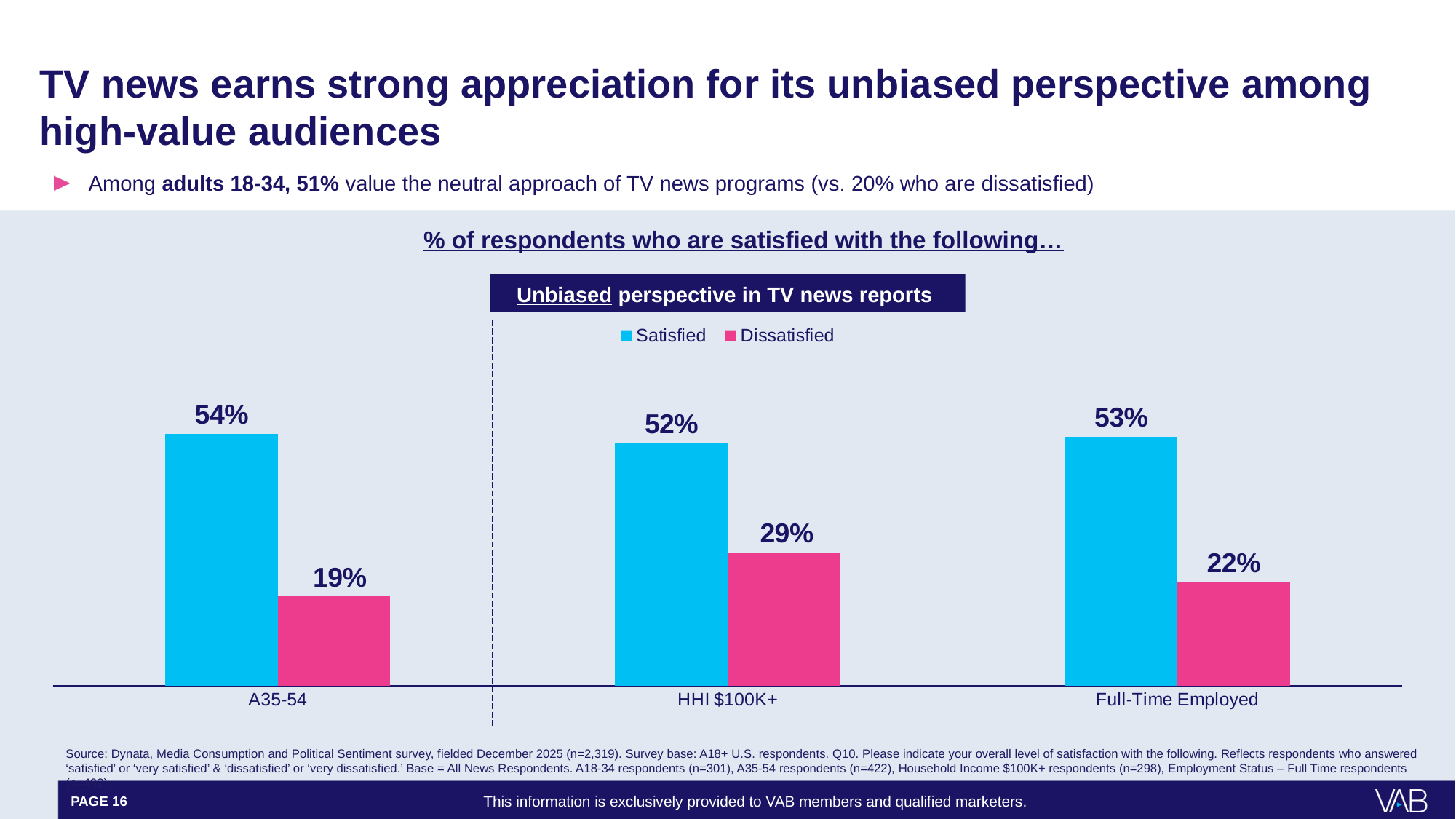
Is the Dissatisfied value larger for HHI $100K+ or for Full-Time Employed? HHI $100K+ What is the difference between the Satisfied and Dissatisfied values for Full-Time Employed respondents? 31 percentage points What percentage of A35-54 respondents are satisfied with the unbiased perspective in TV news reports? 54% What type of chart is shown on the slide? Bar chart What is the Dissatisfied value for A35-54 respondents? 19% What is the difference between the Satisfied values for A35-54 and HHI $100K+? 2 percentage points What is the Satisfied value for Full-Time Employed respondents? 53% Which category has the lowest Dissatisfied value? A35-54 What percentage of HHI $100K+ respondents are dissatisfied with the unbiased perspective in TV news reports? 29% How many categories are shown on the x axis of the chart? 3 Which category has the highest Dissatisfied value? HHI $100K+ How many series does the chart legend list? 2